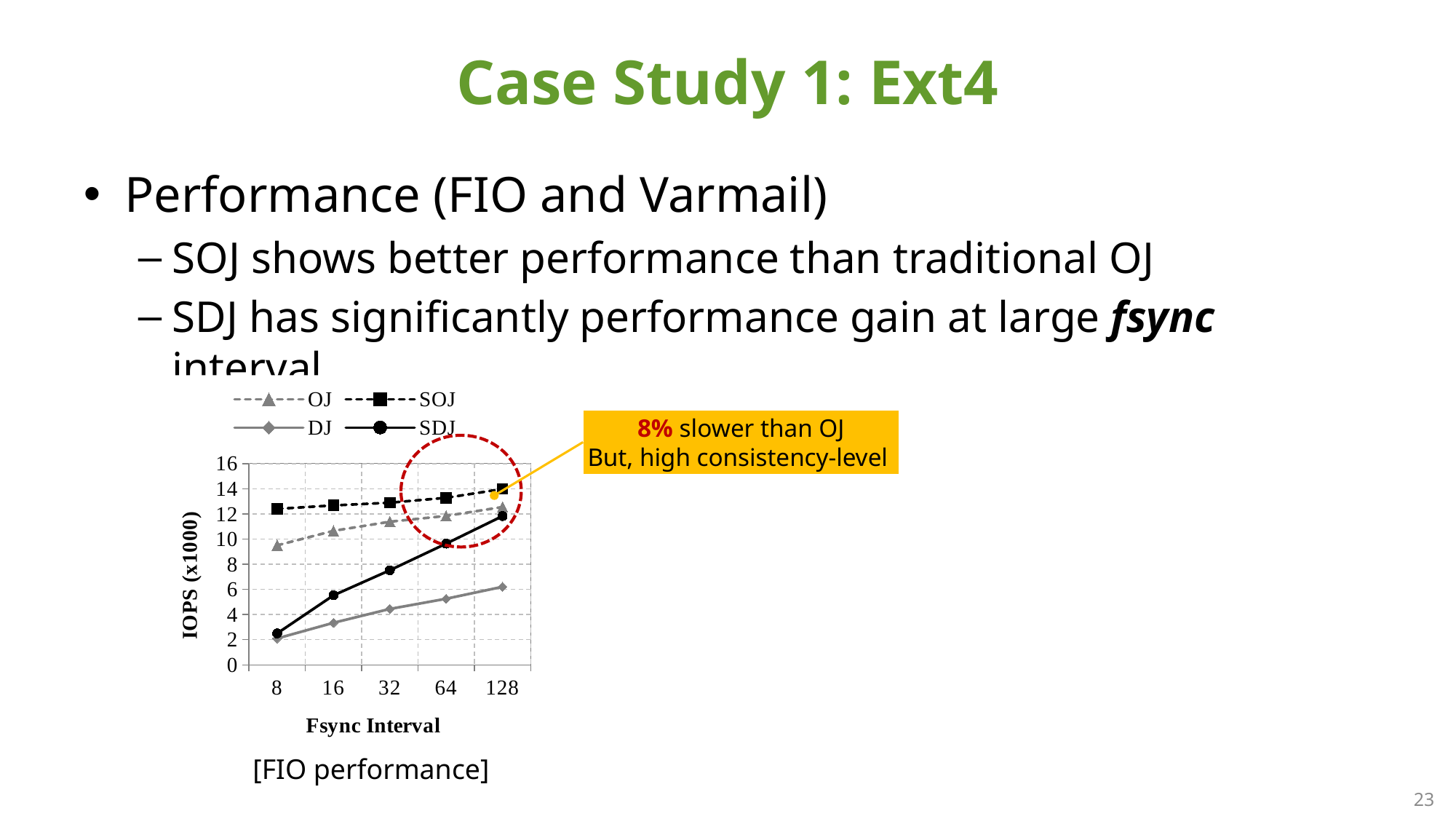
At Fsync Interval 64, which series has the larger IOPS value, OJ or SDJ? OJ Is the IOPS value for DJ at Fsync Interval 128 greater or less than 8? less Is the IOPS value for SOJ at Fsync Interval 8 greater or less than 10? greater At Fsync Interval 32, which series has the larger IOPS value, SOJ or SDJ? SOJ Which series has the highest IOPS at Fsync Interval 128? SOJ How many Fsync Interval values are plotted along the x axis? 5 What kind of chart is shown on the slide? line chart Does the SDJ series rise or fall as the Fsync Interval increases? rises Which series has the lowest IOPS at Fsync Interval 128? DJ How many series does the chart legend list? 4 What is the label of the chart's y axis? IOPS (x1000) Is the IOPS value for SDJ at Fsync Interval 64 greater or less than 8? greater